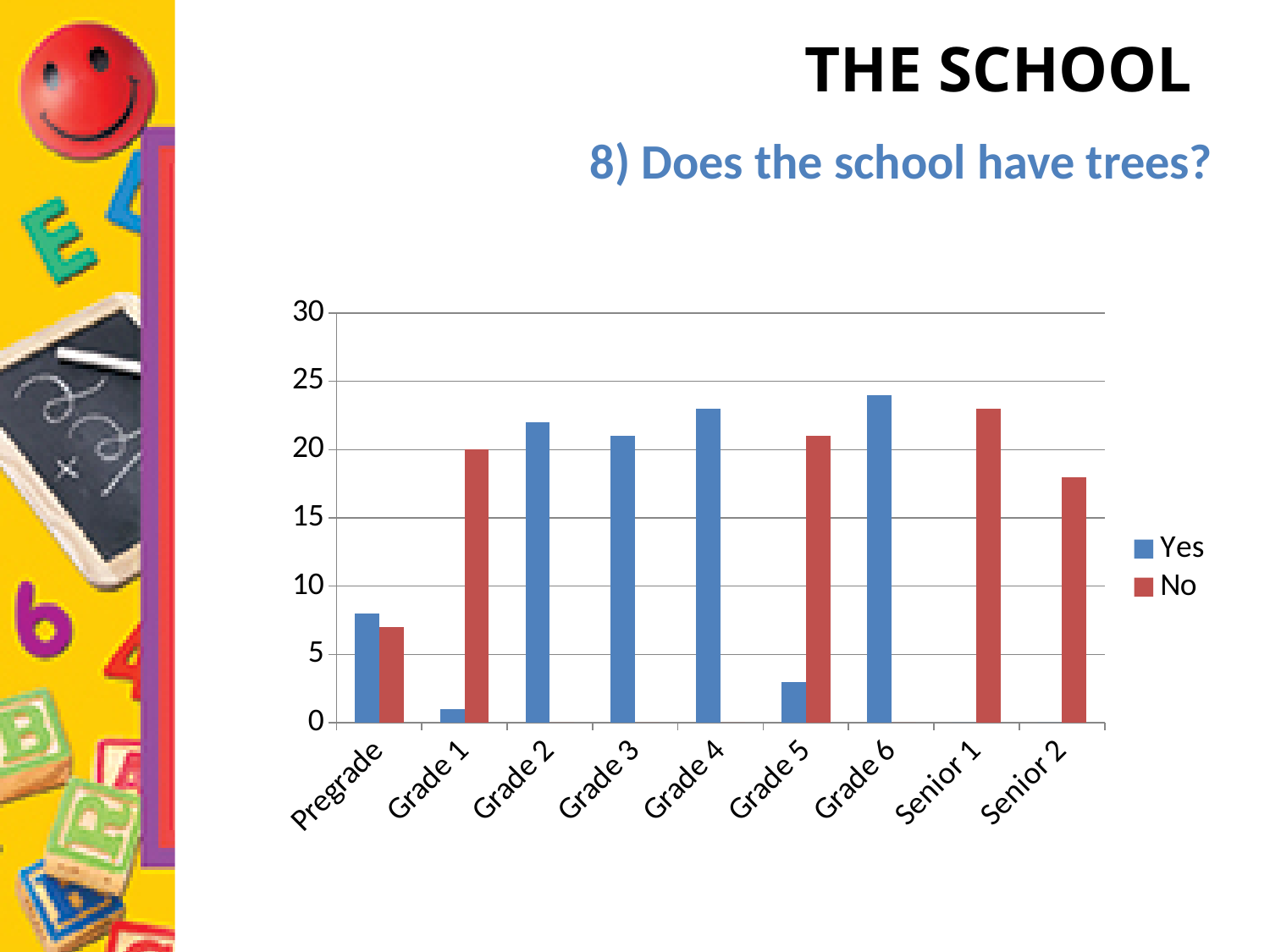
Is the Yes value for Pregrade greater or less than 5? greater What question does the chart's title ask? Does the school have trees? Is the No value for Senior 2 greater or less than 20? less What kind of chart is shown on the slide? bar chart What is the value of the No bar for Grade 1? 20 Is the Yes value for Grade 1 greater or less than 5? less How many series does the legend list? 2 How many categories are shown along the x axis? 9 Which is larger, the Yes value for Grade 4 or the Yes value for Grade 5? Grade 4 Which category has the highest No value? Senior 1